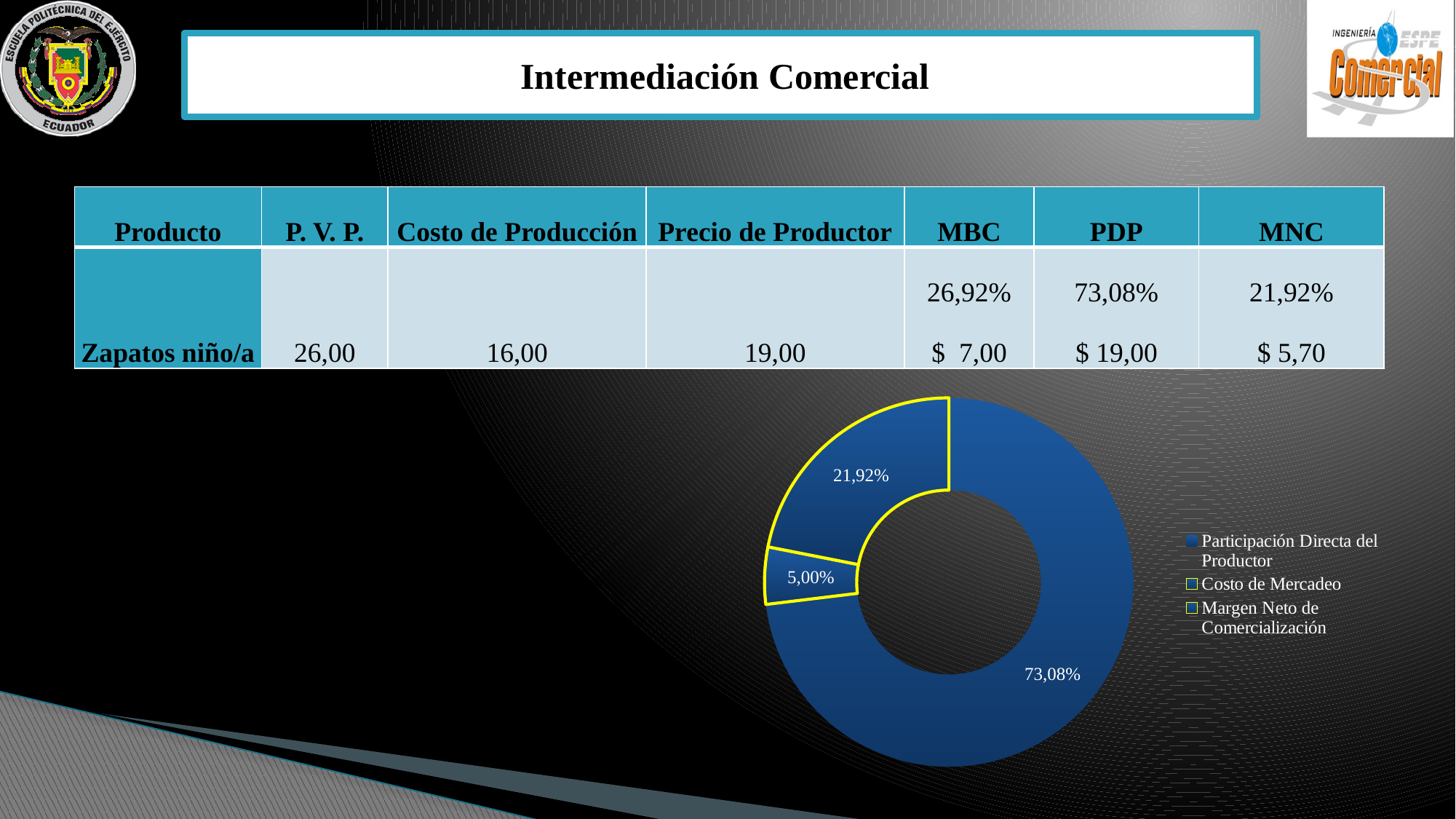
What is the difference between the Participación Directa del Productor share and the Margen Neto de Comercialización share in the doughnut chart? 51,16% How many entries does the legend of the doughnut chart list? 3 Which slice of the doughnut chart is the smallest? Costo de Mercadeo What share of the doughnut chart is Costo de Mercadeo? 5,00% Which slice of the doughnut chart is the largest? Participación Directa del Productor What is the difference between the Margen Neto de Comercialización share and the Costo de Mercadeo share in the doughnut chart? 16,92% Which is larger in the doughnut chart, Margen Neto de Comercialización or Costo de Mercadeo? Margen Neto de Comercialización What is the first entry listed in the legend of the doughnut chart? Participación Directa del Productor How many slices does the doughnut chart have? 3 What share of the doughnut chart is Margen Neto de Comercialización? 21,92% What kind of chart is shown on the slide? Doughnut (pie) chart What share of the doughnut chart is Participación Directa del Productor? 73,08%